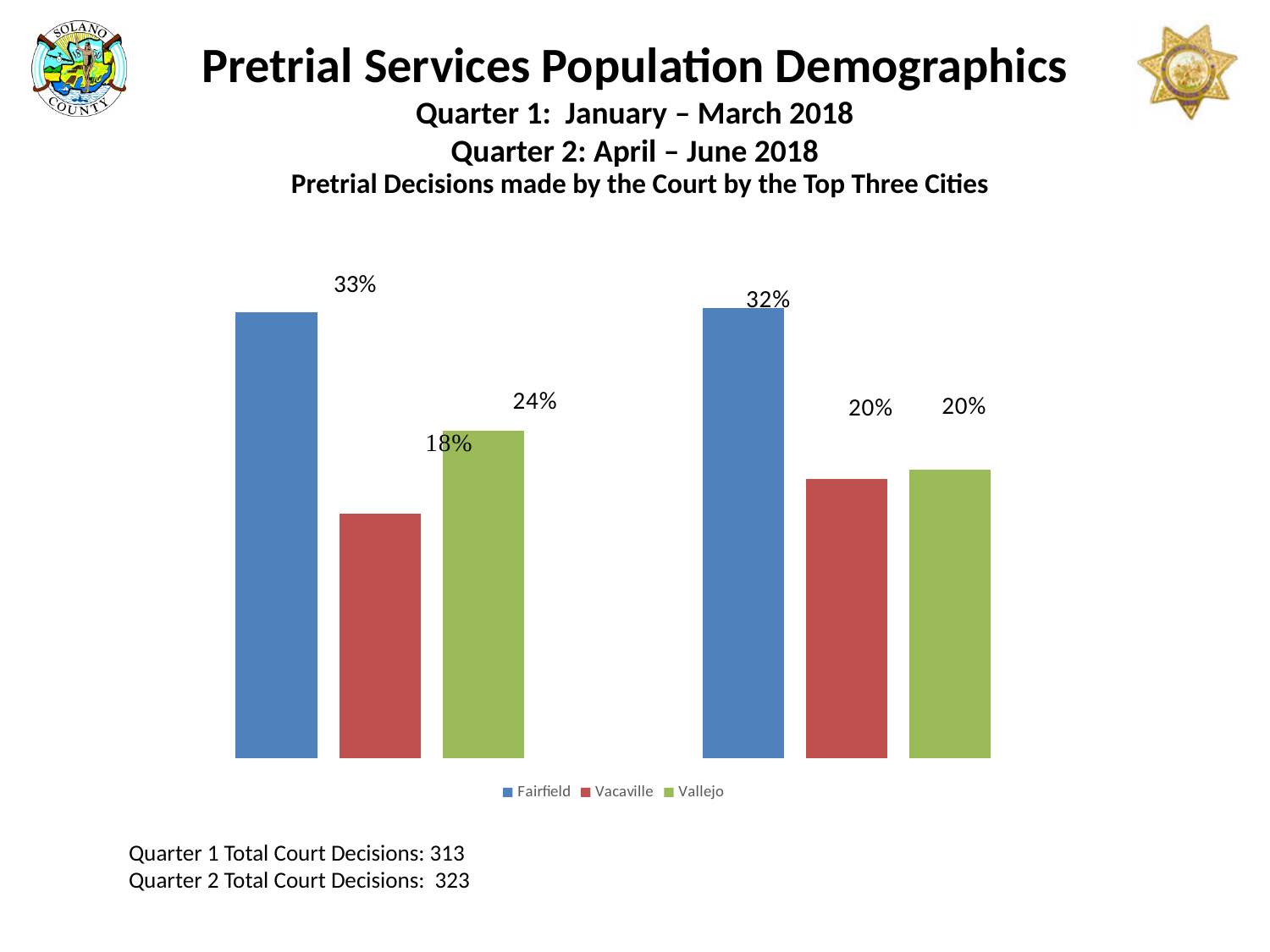
In the right group of bars, what is the value for Fairfield? 32% In the left group of bars, which city has the highest value? Fairfield How many series does the chart legend list? 3 In the left group of bars, what is the value for Fairfield? 33% What kind of chart is shown on the slide? Bar chart Which cities are listed in the chart legend? Fairfield, Vacaville, Vallejo In the left group of bars, what is the value for Vallejo? 24% In the left group of bars, what is the value for Vacaville? 18% In the right group of bars, what is the value for Vacaville? 20% In the left group of bars, what is the difference between the Fairfield and Vacaville values? 15% In the left group of bars, which city has the lowest value? Vacaville In the left group of bars, which is larger, the value for Vallejo or the value for Vacaville? Vallejo